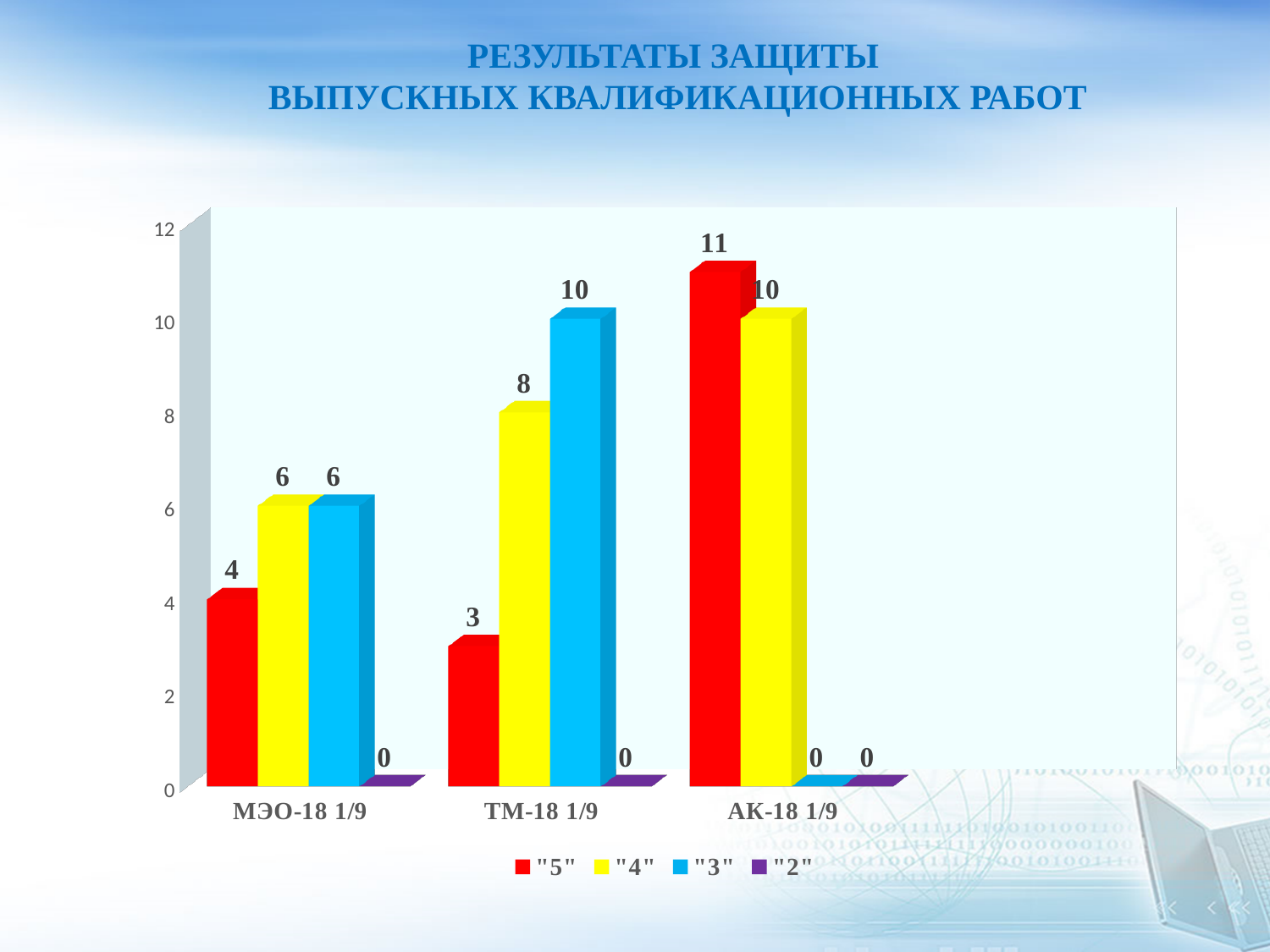
What is the value for "2" in the ТМ-18 1/9 group? 0 What is the difference between the "4" and "5" values in the ТМ-18 1/9 group? 5 What is the value for "3" in the ТМ-18 1/9 group? 10 Which group has the highest value for "5"? АК-18 1/9 What colour represents the "3" series in the legend? Blue How many series does the legend list? 4 What is the value for "4" in the АК-18 1/9 group? 10 How many groups (categories) are shown on the x axis? 3 What kind of chart is shown on the slide? Bar chart Which group has the lowest value for "5"? ТМ-18 1/9 Which is larger in the АК-18 1/9 group: the value for "5" or the value for "4"? "5" What is the value for "5" in the МЭО-18 1/9 group? 4